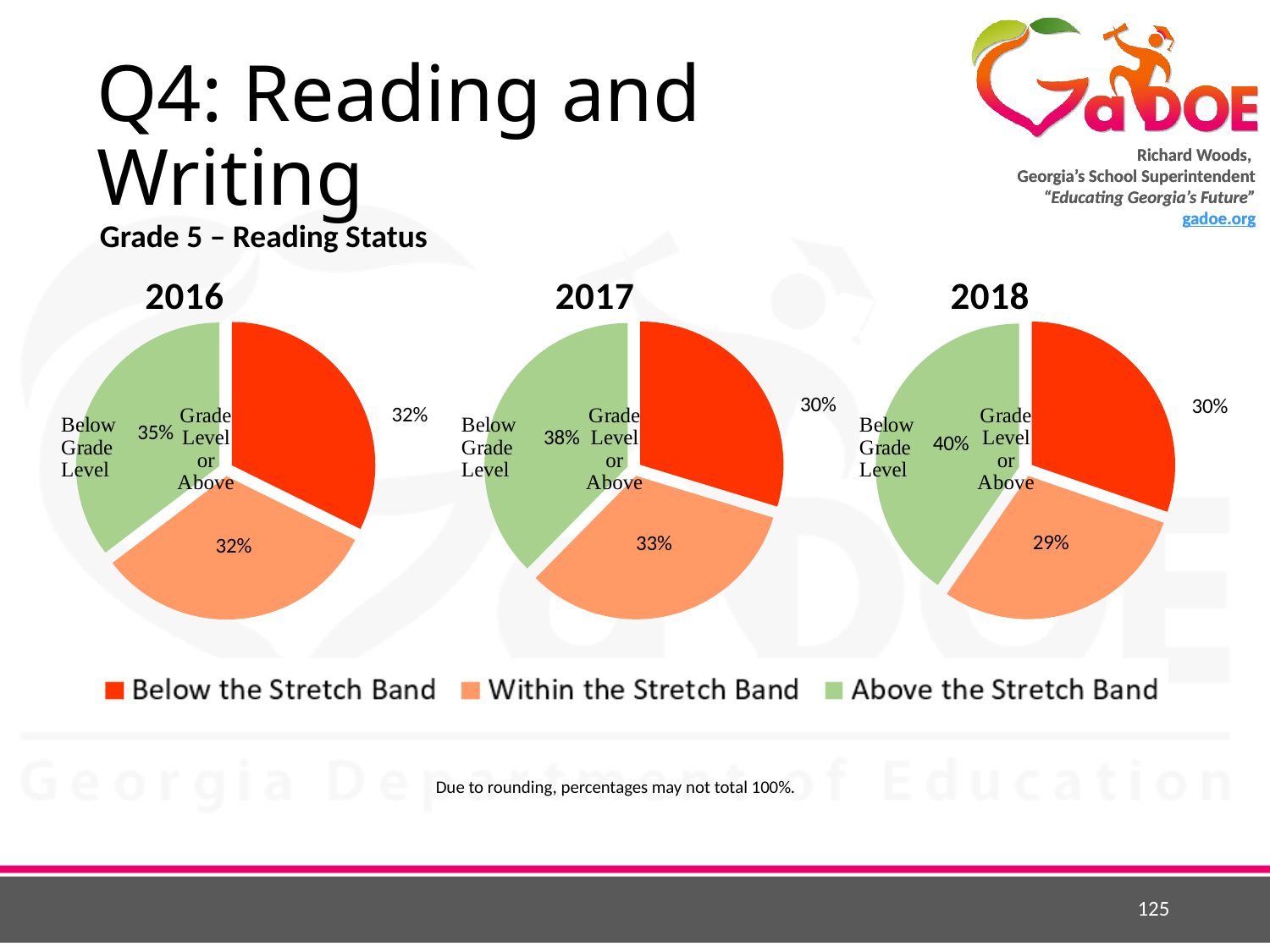
In the 2018 pie chart, what percentage is Within the Stretch Band? 29% In the 2017 pie chart, is the Above the Stretch Band share larger or smaller than the Within the Stretch Band share? larger In the 2016 pie chart, what percentage is Above the Stretch Band? 35% In the 2017 pie chart, what percentage is Within the Stretch Band? 33% In the 2017 pie chart, which category has the smallest share? Below the Stretch Band Across the 2016, 2017 and 2018 pie charts, does the Above the Stretch Band share rise or fall over the years? rise What type of chart is used to show the 2016, 2017 and 2018 reading status? pie chart In the 2018 pie chart, what is the difference between the Above the Stretch Band share and the Within the Stretch Band share? 11% How many slices does the 2016 pie chart have? 3 In the 2018 pie chart, what percentage is Below the Stretch Band? 30% In the 2018 pie chart, which category has the largest share? Above the Stretch Band How many entries does the legend list? 3